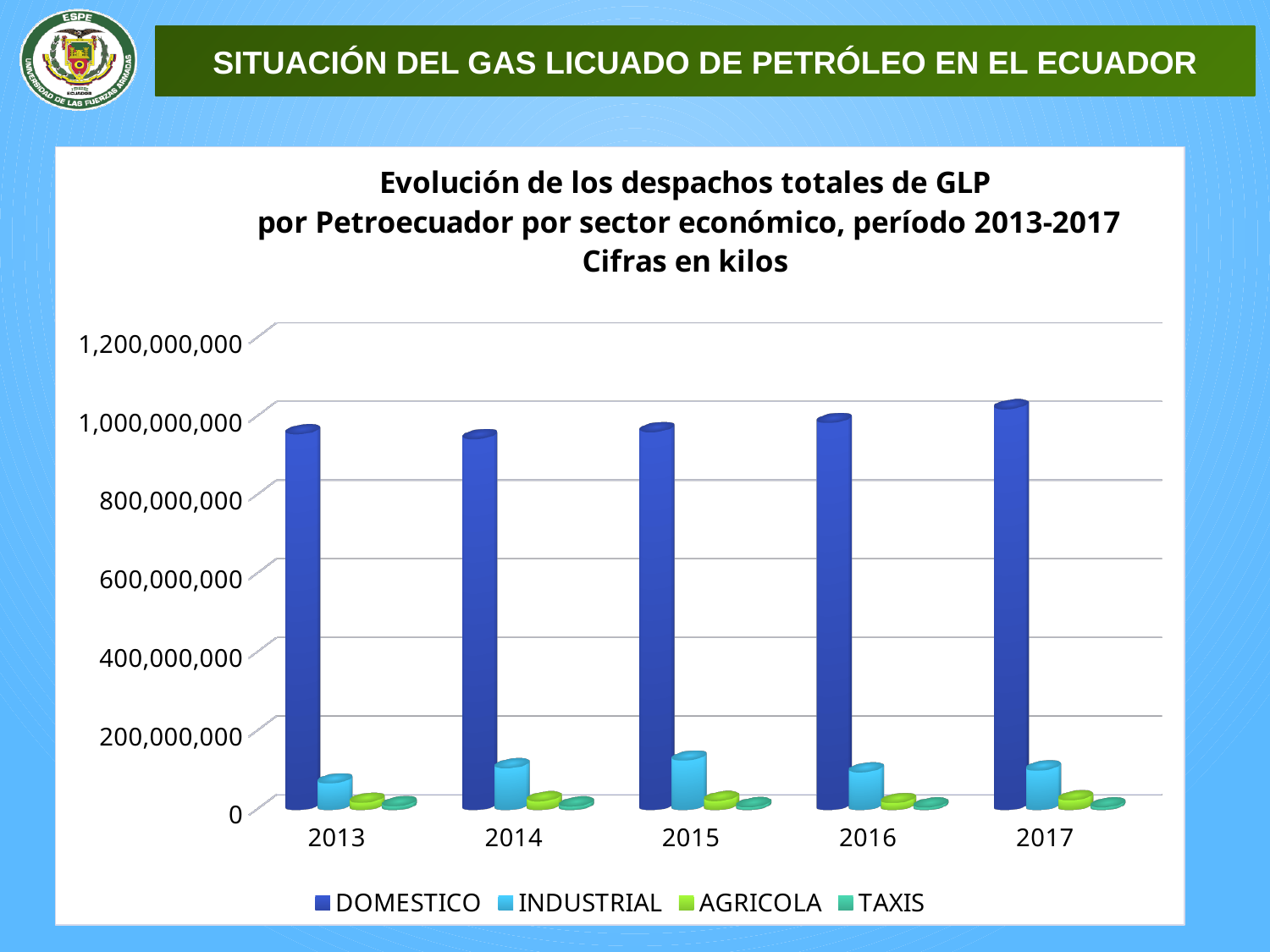
Is the INDUSTRIAL value for 2015 greater or less than 200,000,000? less What kind of chart is shown on the slide? bar chart In 2016, which is larger, DOMESTICO or INDUSTRIAL? DOMESTICO How many years are shown on the x axis? 5 Which series has the tallest bars in every year? DOMESTICO How many series does the legend list? 4 Is the DOMESTICO value for 2016 greater or less than 600,000,000? greater What unit does the chart title say the figures are in? kilos In which year is the INDUSTRIAL bar the highest? 2015 Is the DOMESTICO value for 2013 greater or less than 800,000,000? greater In which year is the DOMESTICO bar the highest? 2017 Do the DOMESTICO values rise or fall from 2014 to 2017? rise